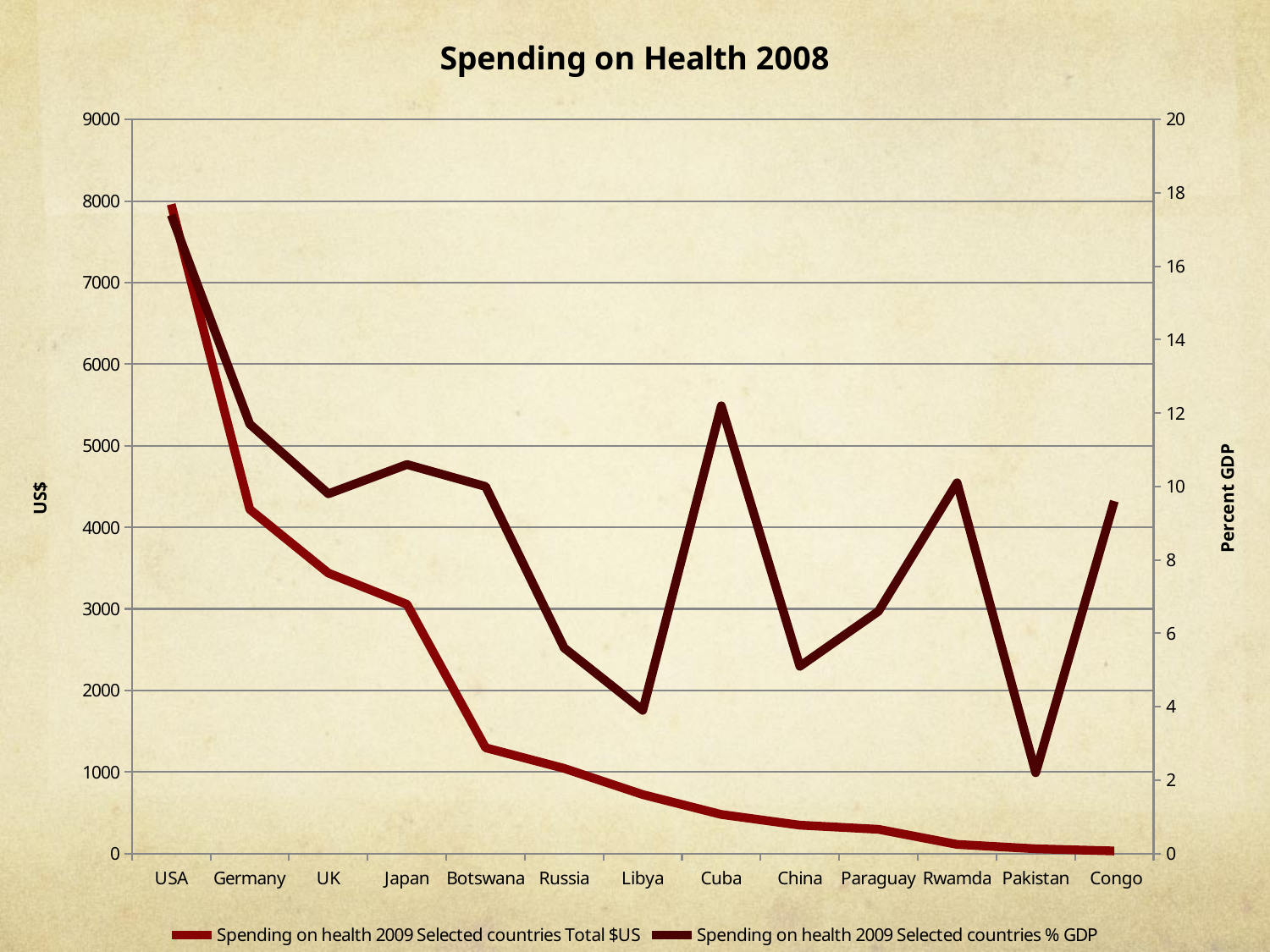
Which has the higher % GDP value, Cuba or Russia? Cuba Does the Total $US line rise or fall from USA to Congo along the x axis? Falls Is the Total $US value for Botswana greater or less than 2000? less Which country has the highest value for Spending on health 2009 Selected countries % GDP? USA What kind of chart is shown on the slide? Line chart How many countries are plotted along the x axis? 13 Is the % GDP value for Cuba greater or less than 10? greater How many series does the legend list? 2 What is the title of the chart? Spending on Health 2008 Is the Total $US value for Germany greater or less than 5000? less Which country has the highest value for Spending on health 2009 Selected countries Total $US? USA Which country has the lowest value for Spending on health 2009 Selected countries % GDP? Pakistan